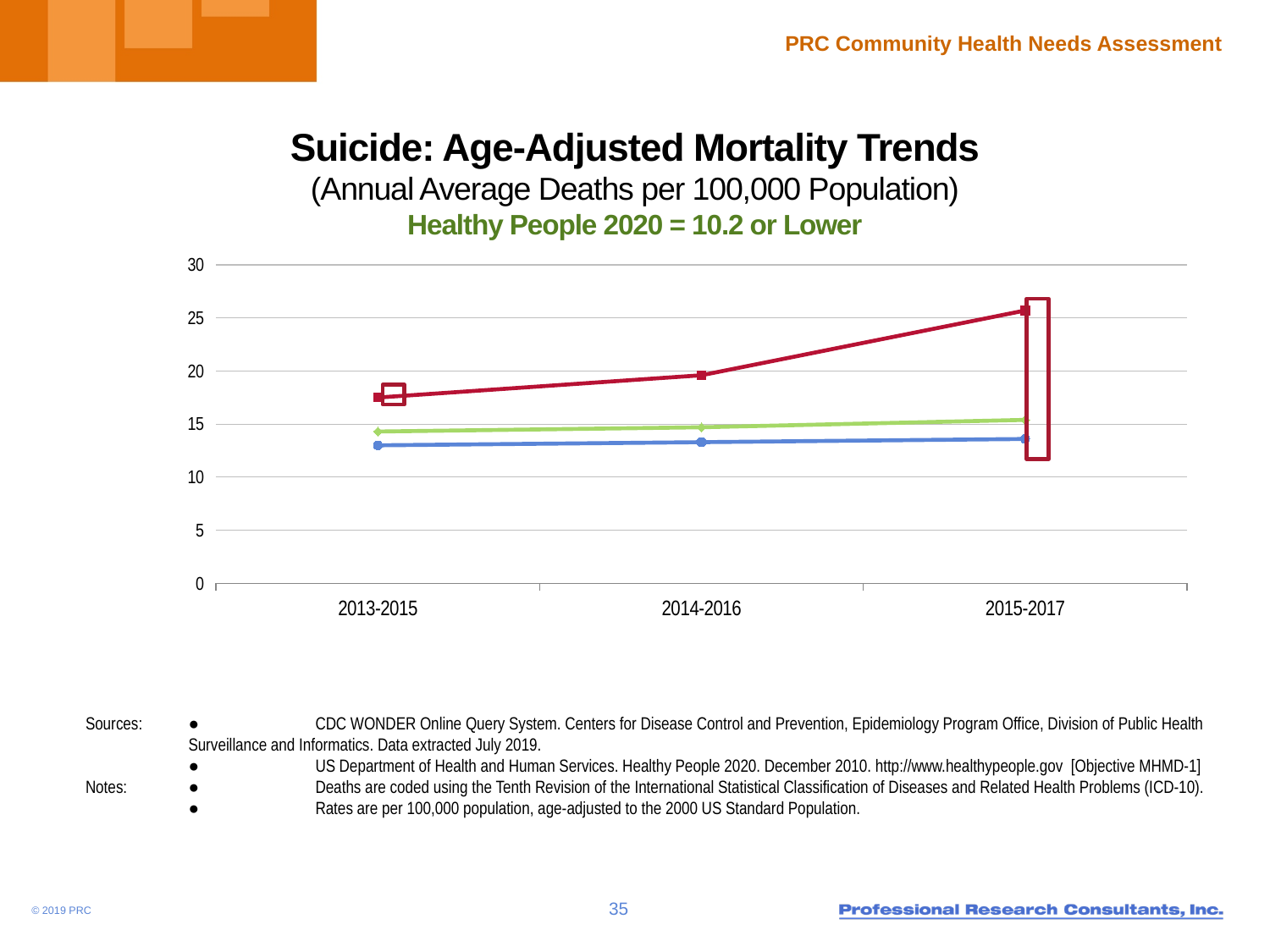
Is the value of the red line for 2015-2017 greater or less than 20? greater Does the red line rise or fall from 2013-2015 to 2015-2017? rise What is the Healthy People 2020 target stated on the slide? 10.2 or Lower How many lines are plotted on the chart? 3 What is the title of the chart? Suicide: Age-Adjusted Mortality Trends How many time periods are shown on the x axis of the chart? 3 Is the value of the red line for 2013-2015 greater or less than 20? less What kind of chart is shown on the slide? line chart In which period does the red line reach its highest value? 2015-2017 Is the value of the green line for 2015-2017 greater or less than 20? less For 2015-2017, which line has the larger value, the red line or the blue line? the red line